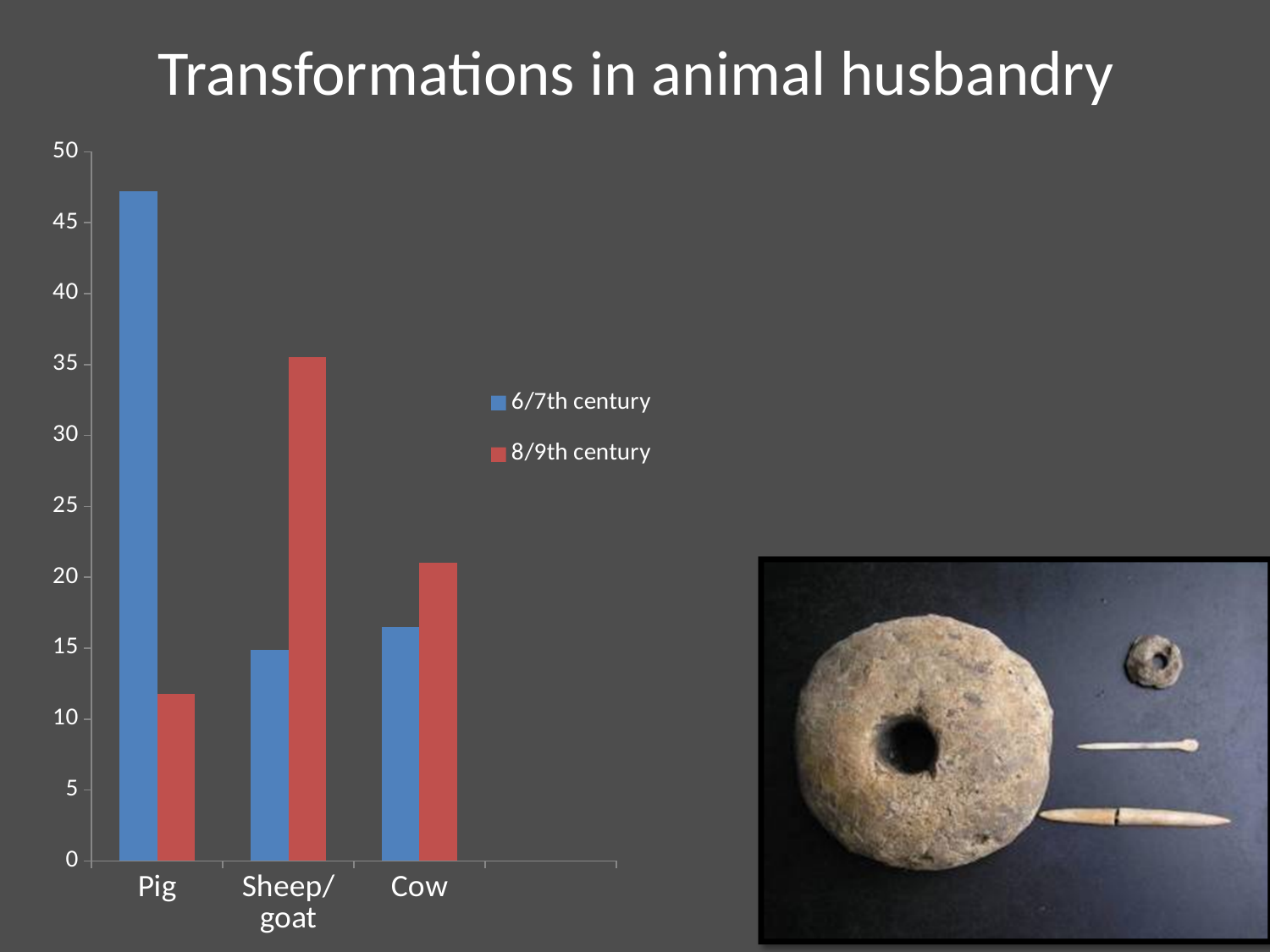
How many series does the legend list? 2 For Cow, which series has the larger value, 6/7th century or 8/9th century? 8/9th century What is the title of the slide containing the chart? Transformations in animal husbandry Which category has the highest value for the 6/7th century series? Pig Is the 8/9th century value for Pig greater or less than 15? less What kind of chart is shown on the slide? bar chart Which category has the lowest value for the 8/9th century series? Pig Is the 6/7th century value for Pig greater or less than 45? greater Is the 8/9th century value for Cow greater or less than 20? greater Which category has the highest value for the 8/9th century series? Sheep/goat How many animal categories are shown on the x axis? 3